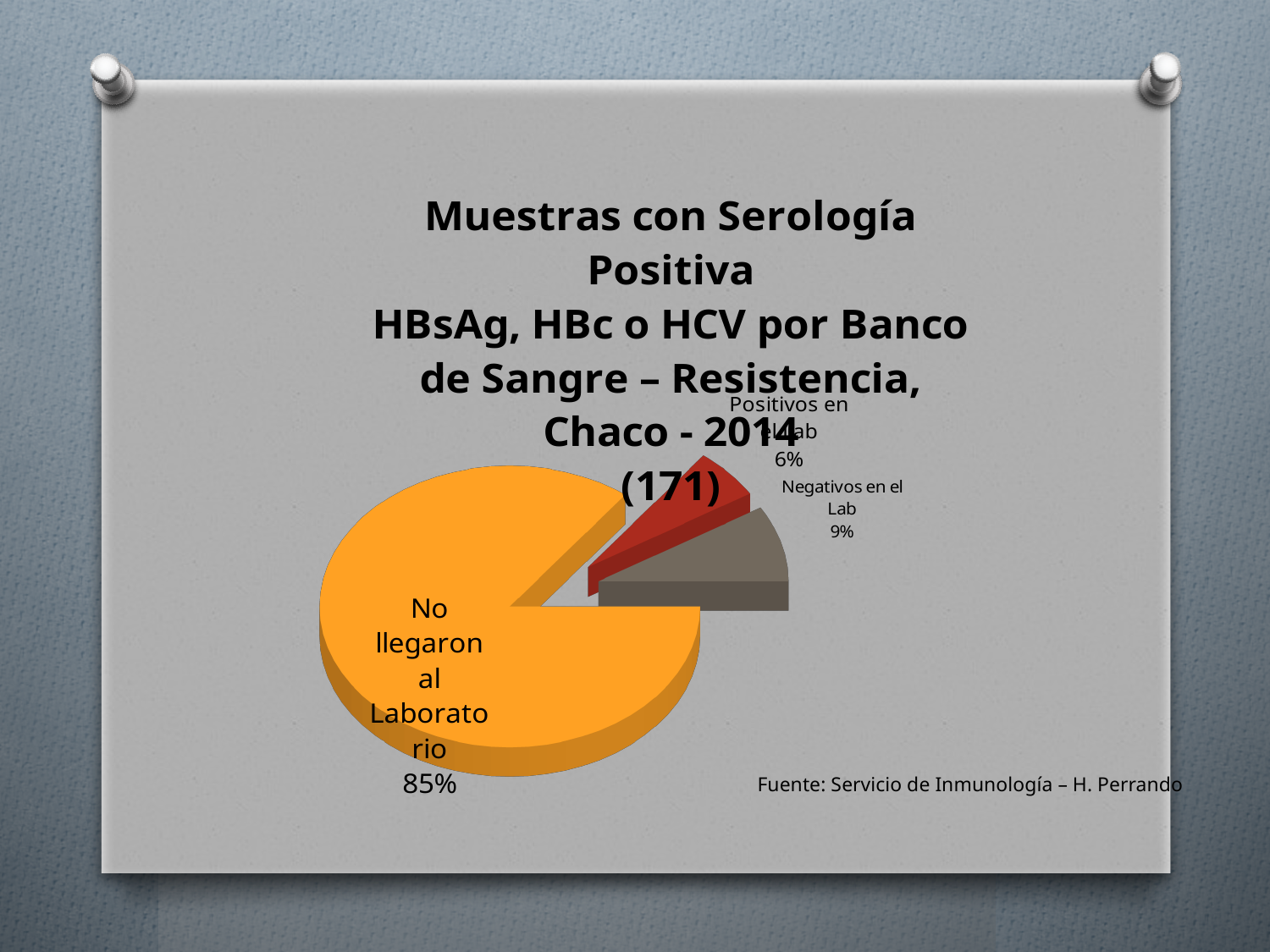
What colour is the "No llegaron al Laboratorio" slice of the pie? Orange What share of the pie is labelled "Positivos en el Lab"? 6% What kind of chart is shown on the slide? Pie chart Which is larger, the share for "Negativos en el Lab" or the share for "Positivos en el Lab"? Negativos en el Lab What share of the pie is labelled "No llegaron al Laboratorio"? 85% What total number of samples is given in parentheses in the chart title? 171 Which slice of the pie is the largest? No llegaron al Laboratorio Which slice of the pie is the smallest? Positivos en el Lab How many slices does the pie chart have? 3 What share of the pie is labelled "Negativos en el Lab"? 9% What is the difference in percentage points between the "Negativos en el Lab" slice and the "Positivos en el Lab" slice? 3 percentage points What is the difference in percentage points between the "No llegaron al Laboratorio" slice and the "Negativos en el Lab" slice? 76 percentage points